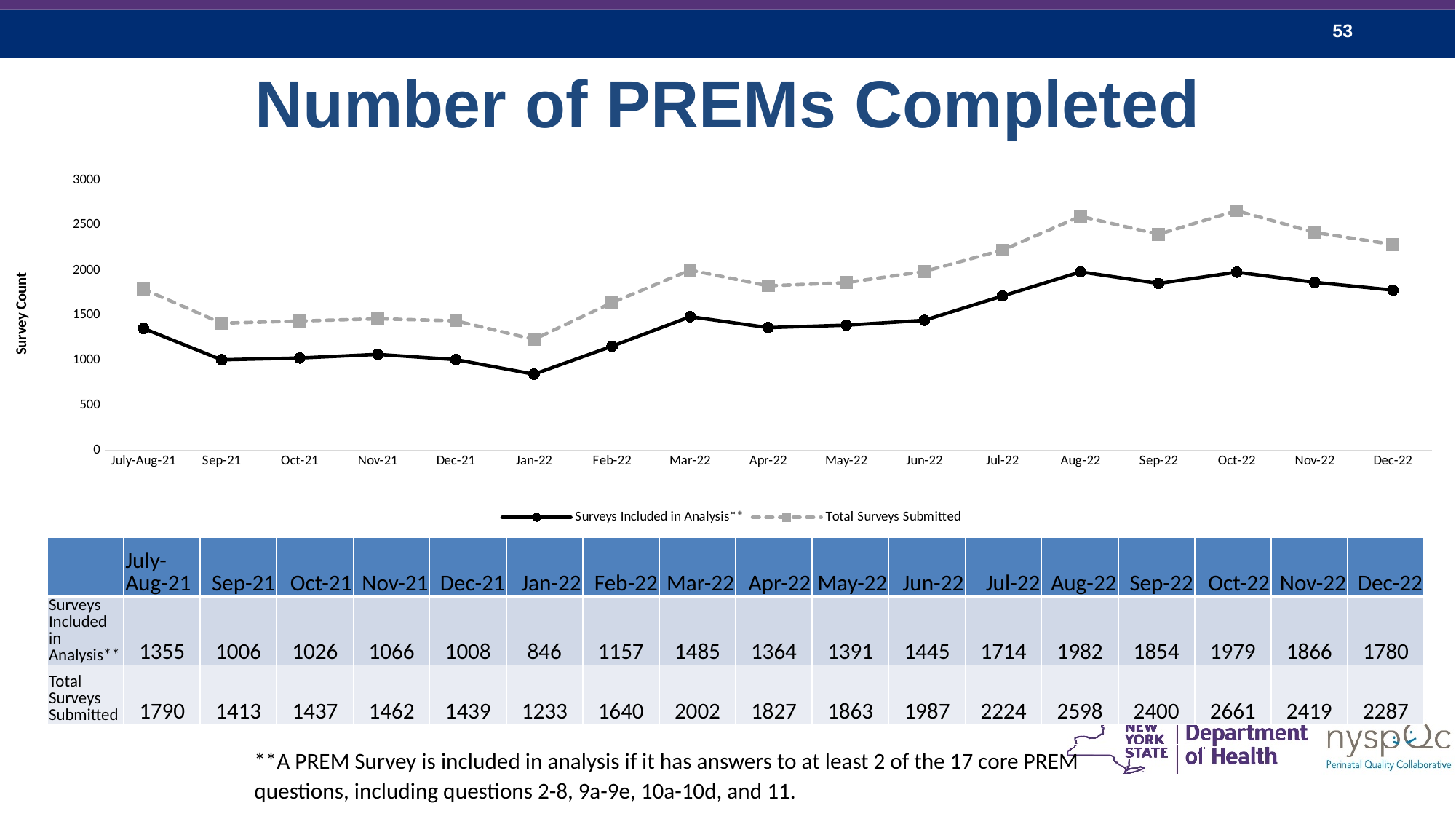
Which period has the lowest value for Surveys Included in Analysis? Jan-22 Is the value for Total Surveys Submitted in Aug-22 greater or less than 2500? greater What is the value of Surveys Included in Analysis for Jan-22? 846 What type of chart is shown on the slide? line chart Do the Surveys Included in Analysis values rise or fall from Jan-22 to Mar-22? rise What is the value of Total Surveys Submitted for Oct-22? 2661 How many series does the legend list? 2 How many time periods are plotted along the x axis? 17 What is the label of the y axis? Survey Count What is the difference between Total Surveys Submitted and Surveys Included in Analysis for Dec-22? 507 Which is larger: Total Surveys Submitted in Aug-22 or in Sep-22? Aug-22 Which period has the highest value for Total Surveys Submitted? Oct-22